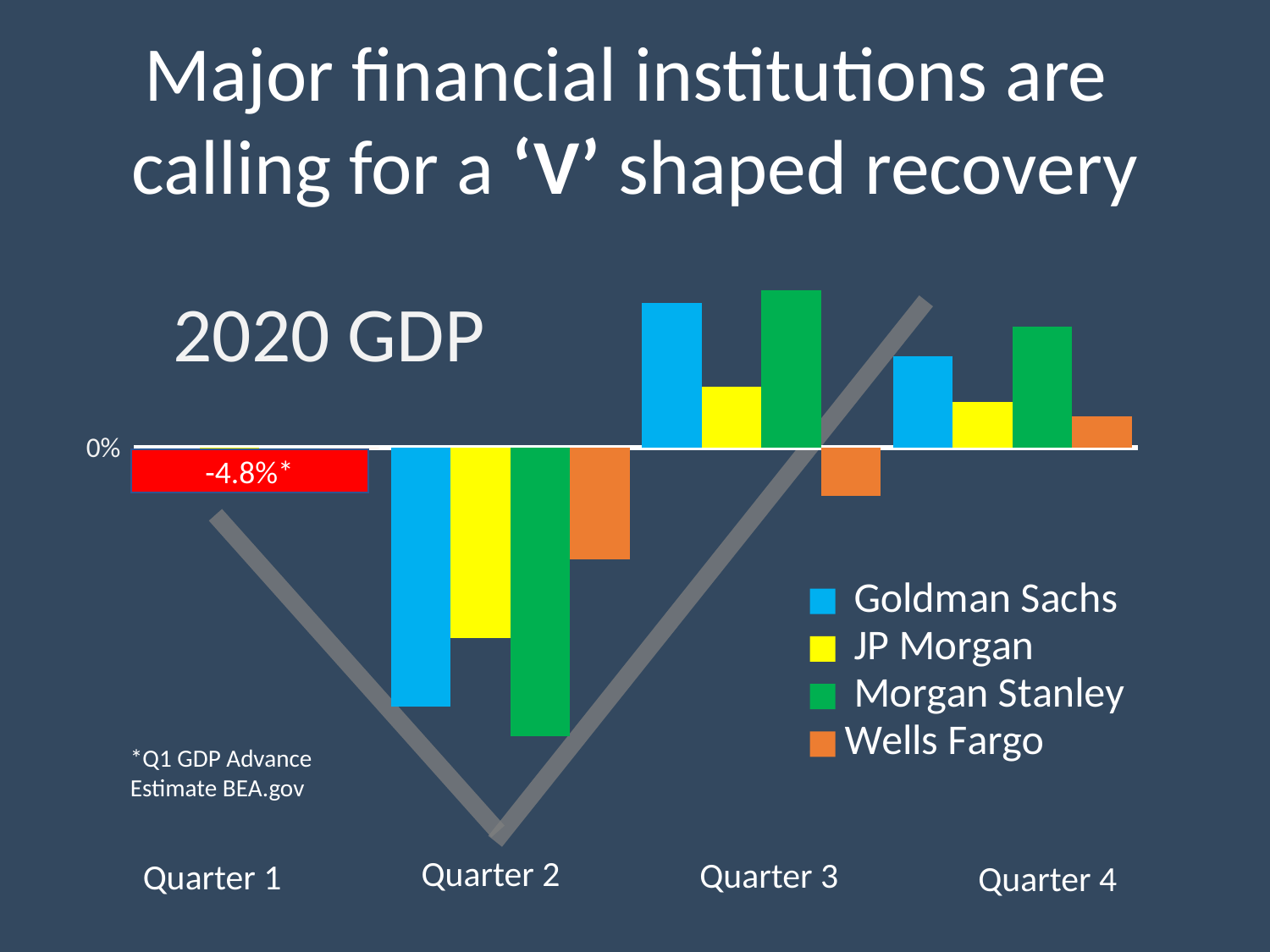
Is the value for Wells Fargo in Quarter 3 greater or less than 0%? less How many quarters are shown on the x axis? 4 What kind of chart is shown on the slide? bar chart Does the value for Morgan Stanley rise or fall from Quarter 3 to Quarter 4? fall Which institution has the lowest value in Quarter 4? Wells Fargo What is the title of the chart? 2020 GDP Is the value for Goldman Sachs in Quarter 3 greater or less than 0%? greater What value is labelled on the Quarter 1 bar? -4.8% Which institution has the highest value in Quarter 3? Morgan Stanley How many institutions does the legend list? 4 In Quarter 2, which is larger: the value for Wells Fargo or the value for Goldman Sachs? Wells Fargo Which institution has the lowest value in Quarter 2? Morgan Stanley